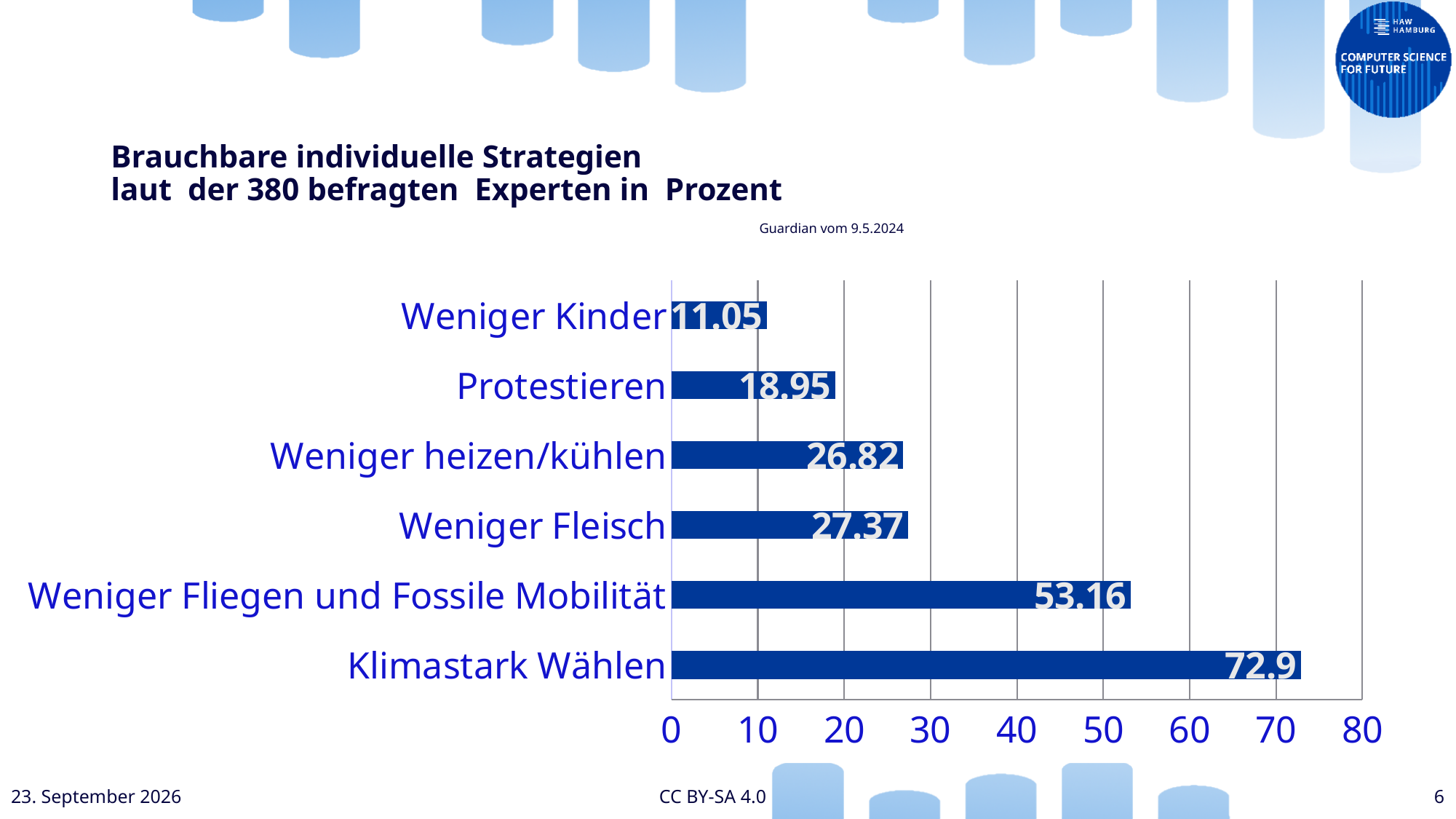
Which is larger, the value for Weniger Fleisch or the value for Weniger heizen/kühlen? Weniger Fleisch What kind of chart is shown on the slide? bar chart What is the source cited below the chart title? Guardian vom 9.5.2024 What is the value for Weniger Fliegen und Fossile Mobilität? 53.16 Is the value for Weniger Fliegen und Fossile Mobilität greater or less than 50? greater What is the value for Klimastark Wählen? 72.9 What is the difference between the values for Klimastark Wählen and Weniger Fliegen und Fossile Mobilität? 19.74 What is the value for Weniger Kinder? 11.05 Which category has the highest value? Klimastark Wählen What is the value for Protestieren? 18.95 Which category has the lowest value? Weniger Kinder How many categories are shown in the chart? 6